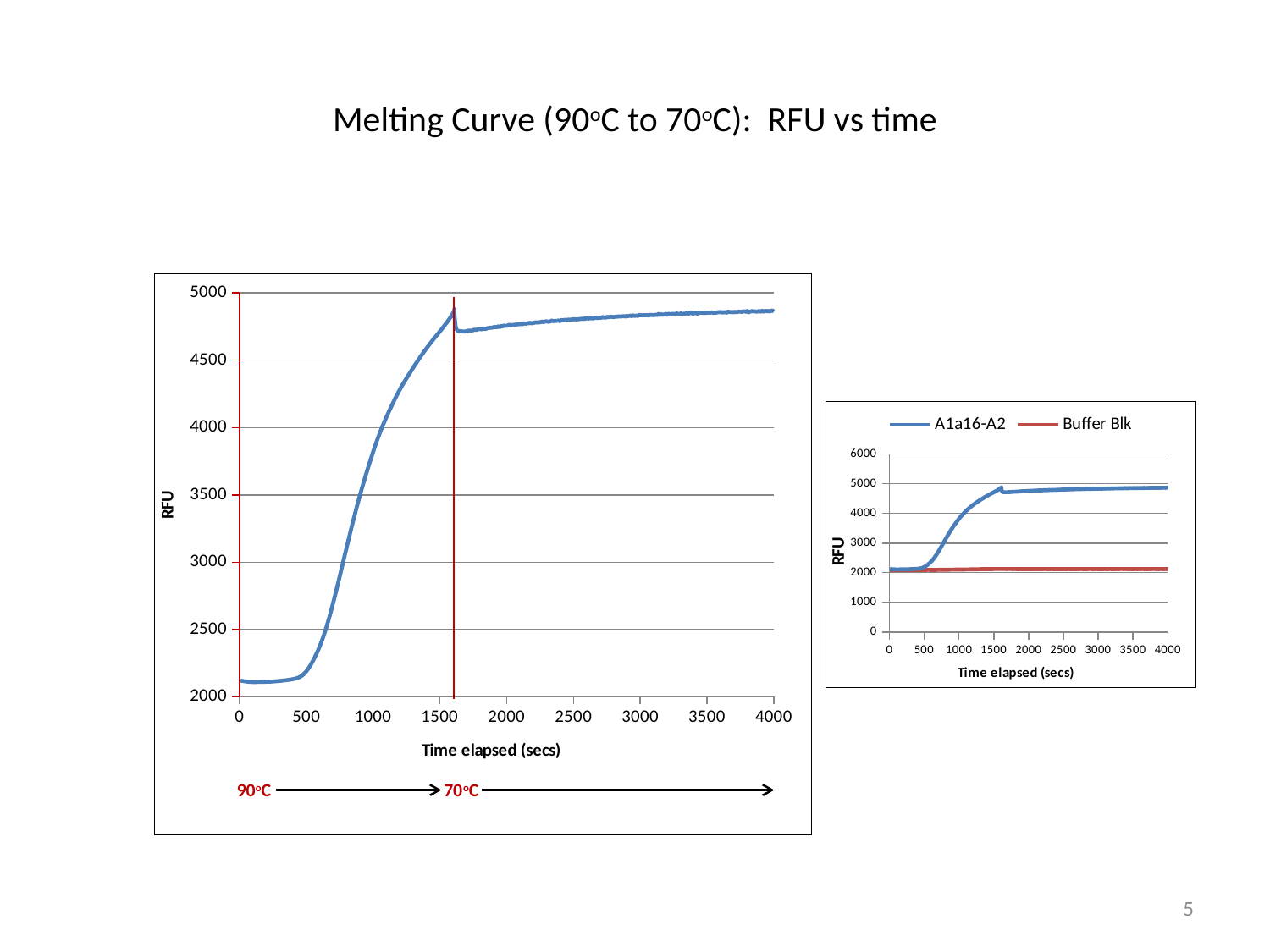
In the small chart on the right, is the Buffer Blk value at 4000 seconds greater or less than 3000? less In the small chart on the right, does the Buffer Blk series rise sharply, fall sharply, or stay roughly flat over time? stay roughly flat In the large chart on the left, is the RFU value at 4000 seconds greater or less than 4500? greater In the small chart on the right, is the A1a16-A2 value at 4000 seconds greater or less than 4000? greater In the large chart on the left, does the RFU value overall rise or fall as time elapsed increases from 0 to 4000 seconds? rise What kind of chart is the large chart on the left of the slide? line chart What is the x-axis title of the large chart on the left? Time elapsed (secs) In the small chart on the right, which series is higher at 4000 seconds, A1a16-A2 or Buffer Blk? A1a16-A2 How many series does the legend of the small chart on the right list? 2 What is the y-axis title of the small chart on the right? RFU